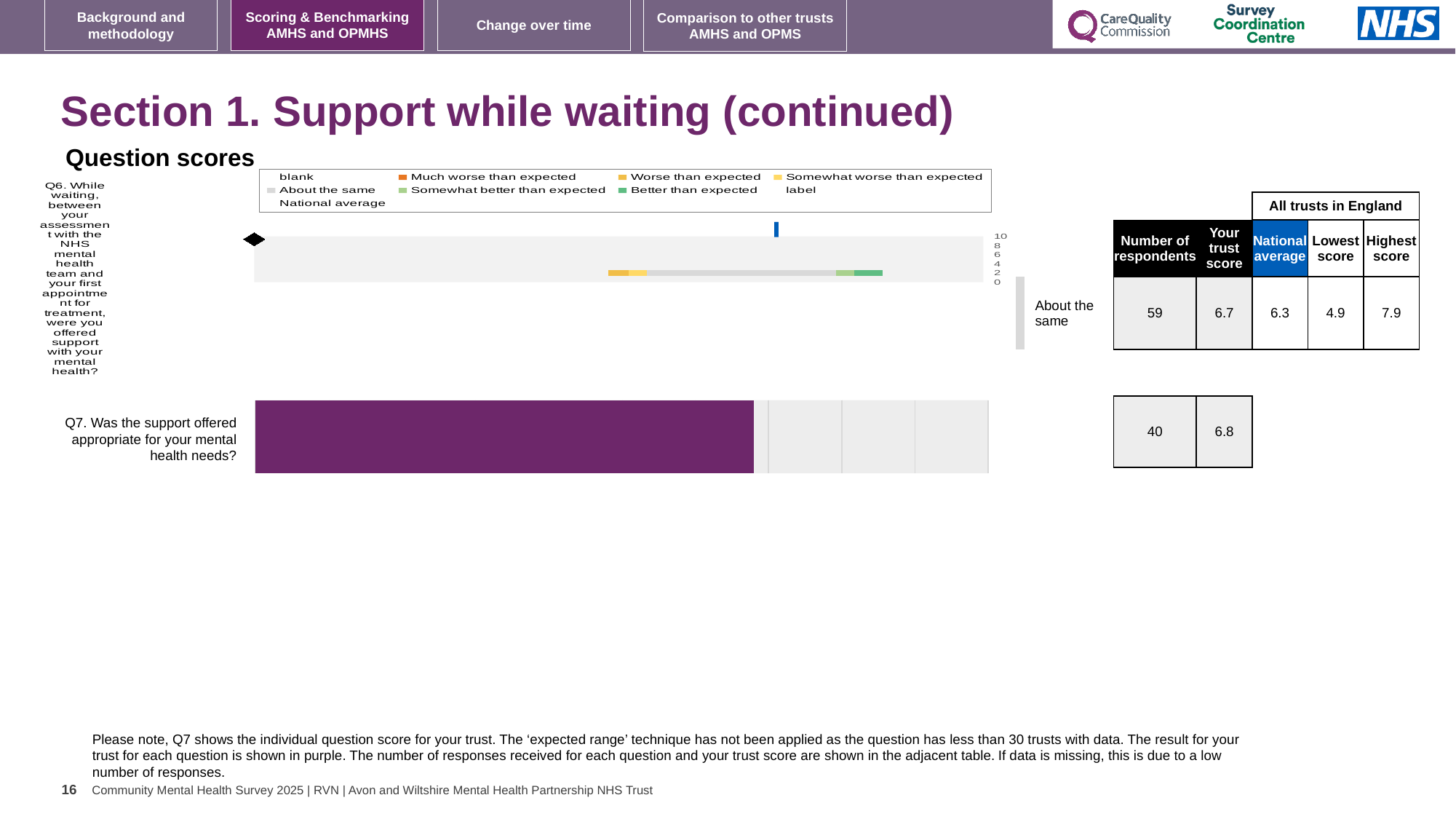
What category label is given to the trust's Q6 result? About the same What is the difference between the trust score and the national average for Q6? 0.4 What is the trust score for Q6 shown in the table next to the chart? 6.7 What is the difference between the highest and lowest scores for Q6? 3.0 What kind of chart is used to show the Q6 and Q7 scores? Bar chart What is the national average score for Q6? 6.3 What is the lowest score among all trusts in England for Q6? 4.9 How many respondents answered Q6? 59 Which is larger for Q6, the trust score or the national average? Trust score What is the trust score for Q7? 6.8 What is the highest score among all trusts in England for Q6? 7.9 What colour is the bar for Q7? Purple